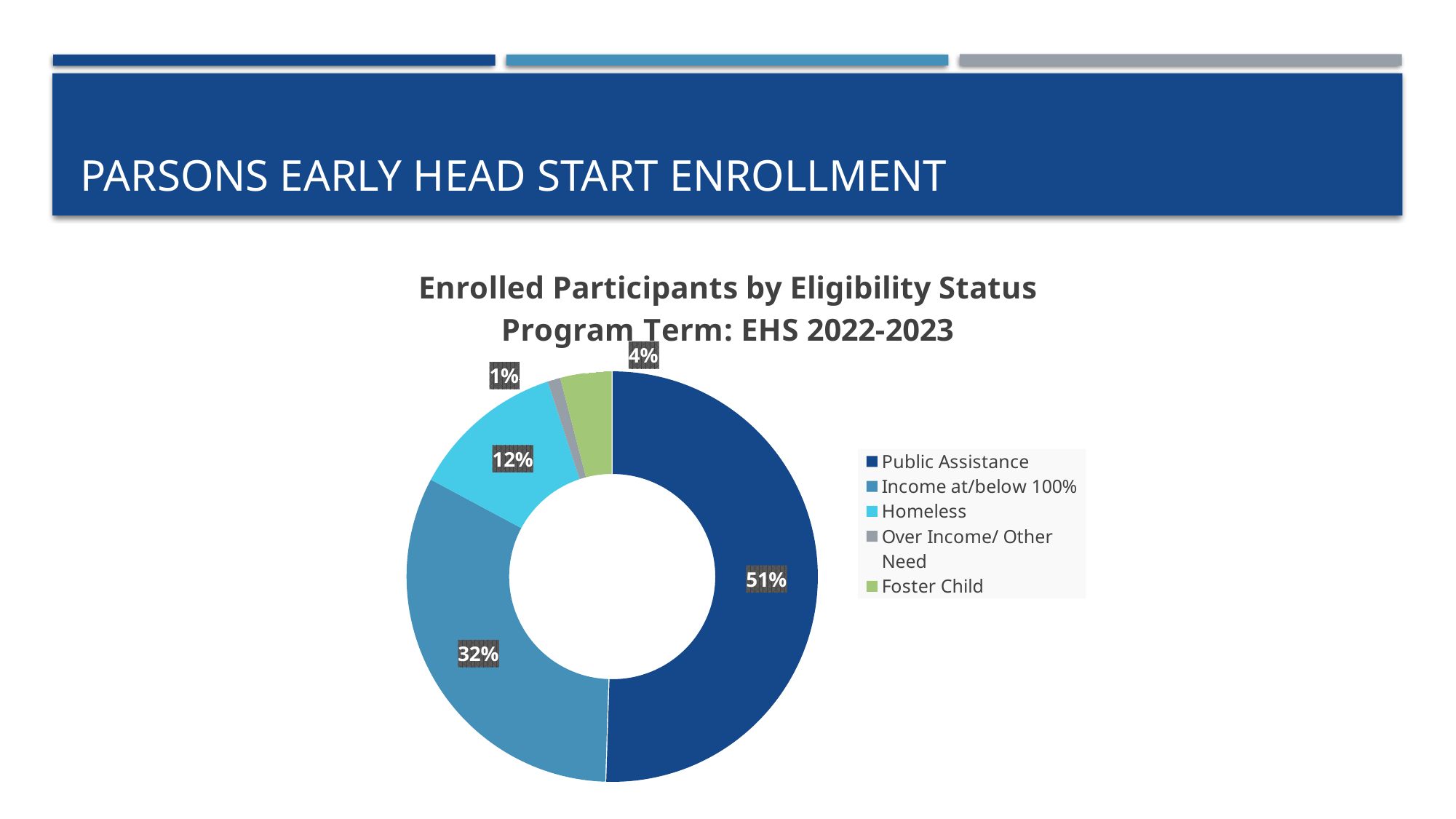
What percentage of enrolled participants fall under Over Income/ Other Need? 1% What percentage of enrolled participants are Foster Child? 4% What type of chart is used to show enrolled participants by eligibility status? Doughnut (pie) chart What percentage of enrolled participants are eligible through Public Assistance? 51% What is the difference in percentage points between Public Assistance and Income at/below 100%? 19 Which eligibility status has the smallest share of enrolled participants? Over Income/ Other Need What share of enrolled participants are Homeless? 12% Which is larger: the share for Homeless or the share for Foster Child? Homeless What percentage of enrolled participants are in the Income at/below 100% category? 32% What program term does the chart title state? EHS 2022-2023 How many eligibility categories are shown in the chart? 5 Which eligibility status has the largest share of enrolled participants? Public Assistance